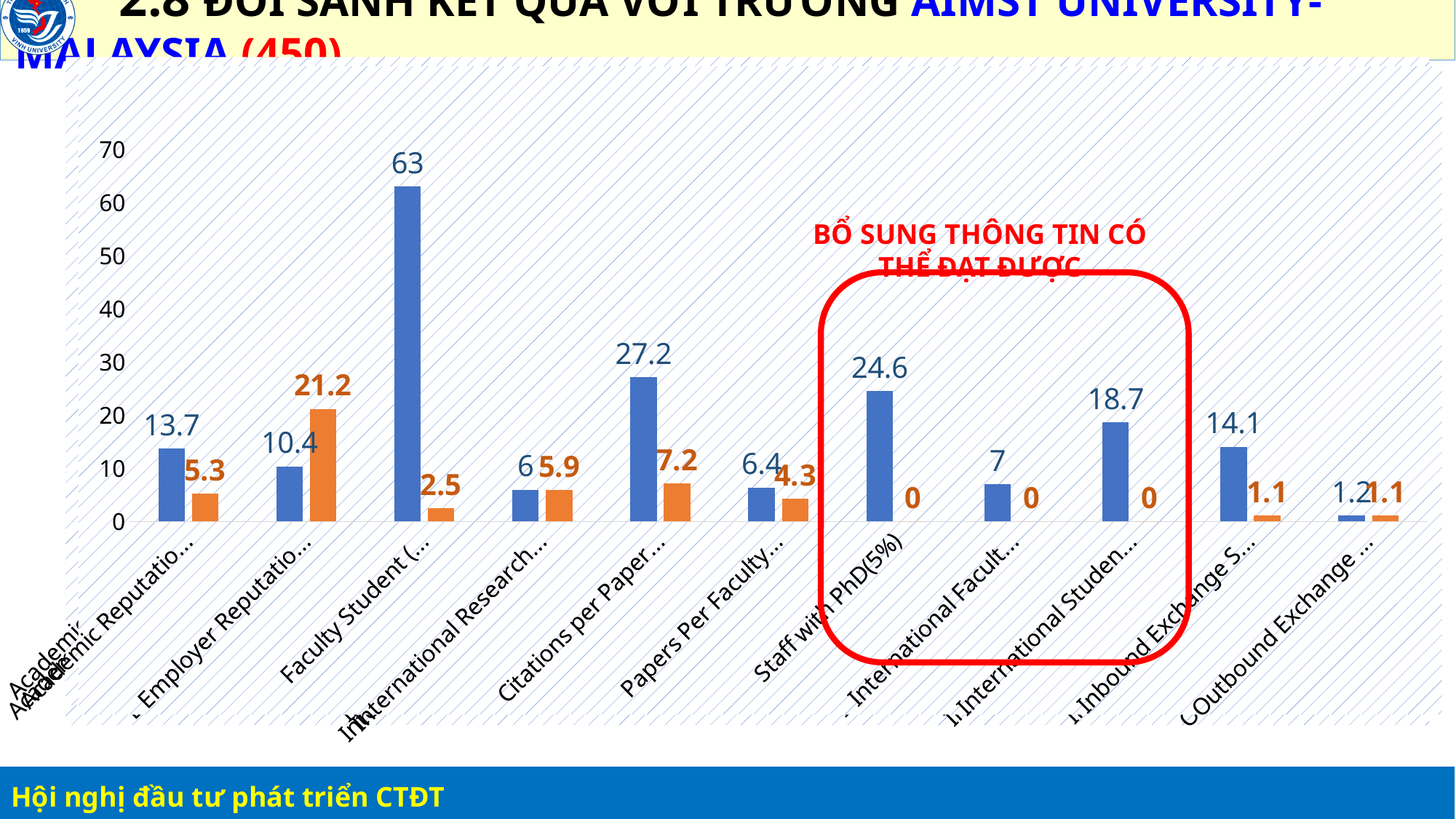
What is the value of the blue bar for Staff with PhD(5%)? 24.6 Is the blue bar for Citations per Paper greater or less than 20? greater What kind of chart is shown on the slide? bar chart Which category has the highest orange bar? Employer Reputation How many categories have an orange bar with a value of 0? 3 For Employer Reputation, which bar is larger, the blue or the orange? orange What is the difference between the blue bars for Staff with PhD(5%) and International Faculty? 17.6 What is the value of the orange bar for International Faculty? 0 Which category has the highest blue bar? Faculty Student What is the difference between the blue and orange bars for Faculty Student? 60.5 What is the value of the orange bar for Employer Reputation? 21.2 How many categories are shown on the x axis? 11